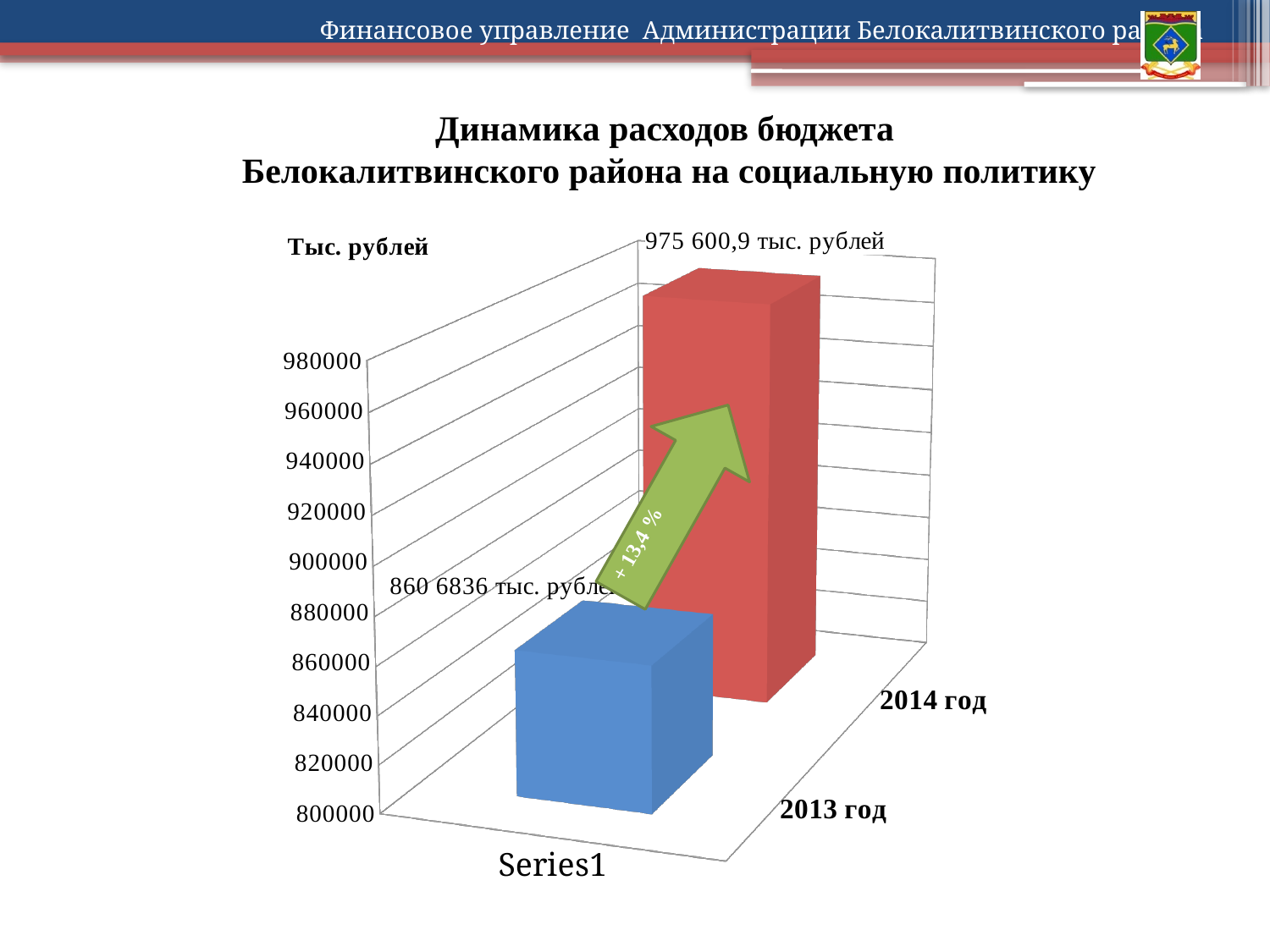
Which year has the lowest value? 2013 год What is the value shown for 2014 год? 975 600,9 тыс. рублей Which year has the highest value? 2014 год How many categories (years) are plotted in the chart? 2 What is the value printed for 2013 год? 860 6836 Which is larger, the value for 2013 год or for 2014 год? 2014 год Do the values rise or fall from 2013 год to 2014 год? rise Is the value for 2014 год greater or less than 900000? greater What is the title of the chart? Динамика расходов бюджета Белокалитвинского района на социальную политику What percentage change is written on the green arrow? + 13,4 % What kind of chart is shown on the slide? bar chart